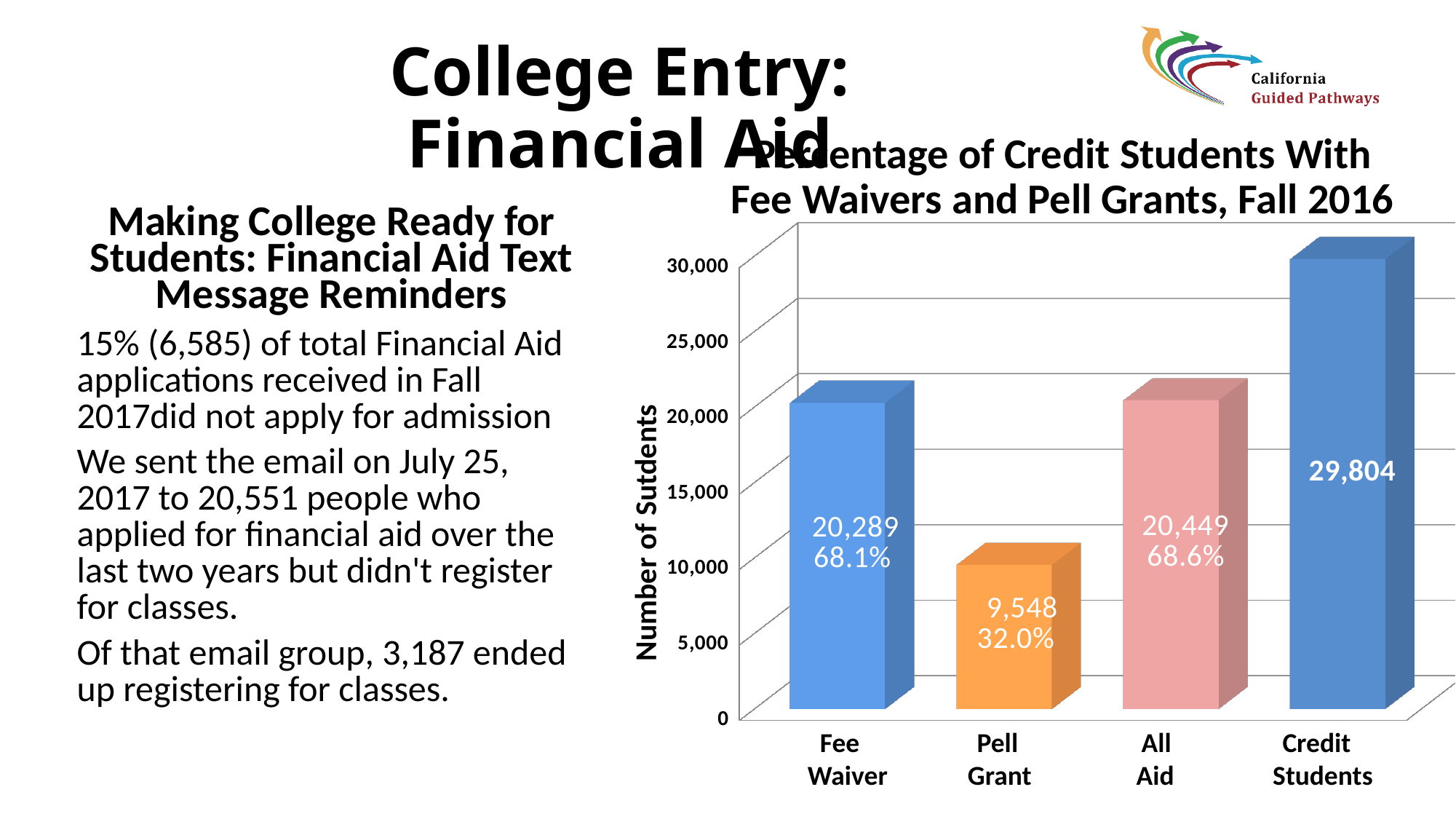
Is the value for Pell Grant greater or less than 10,000? less What type of chart is shown on the slide? Bar chart What is the difference between the Credit Students value and the Pell Grant value? 20,256 What percentage is shown on the Pell Grant bar? 32.0% What is the difference between the Fee Waiver value and the Pell Grant value? 10,741 What is the value shown for Credit Students? 29,804 Which category has the highest number of students? Credit Students Which is larger, the value for Credit Students or the value for All Aid? Credit Students What is the number of students with a Fee Waiver? 20,289 How many categories are shown on the x axis of the chart? 4 What is the number of students in the All Aid category? 20,449 Which category has the lowest number of students? Pell Grant